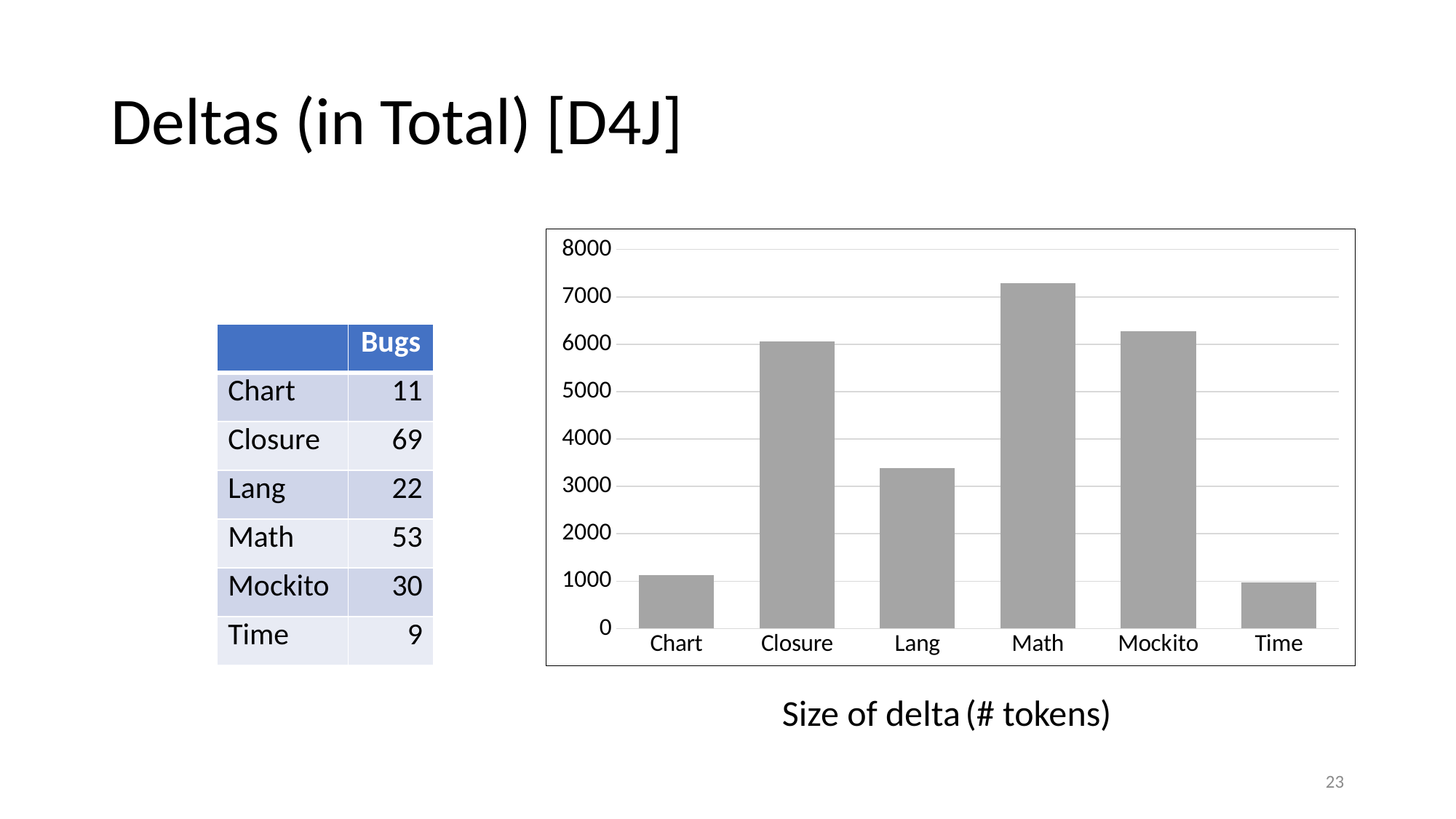
Which category has the tallest bar in the chart? Math Which category has the shortest bar in the chart? Time What does the caption below the chart say the bars measure? Size of delta (# tokens) Is the value for Lang greater or less than 4000? less How many categories are plotted on the x axis of the chart? 6 Which has a larger value in the chart, Chart or Mockito? Mockito Is the value for Math greater or less than 7000? greater What kind of chart is shown on the slide? bar chart Which has a larger value in the chart, Lang or Closure? Closure